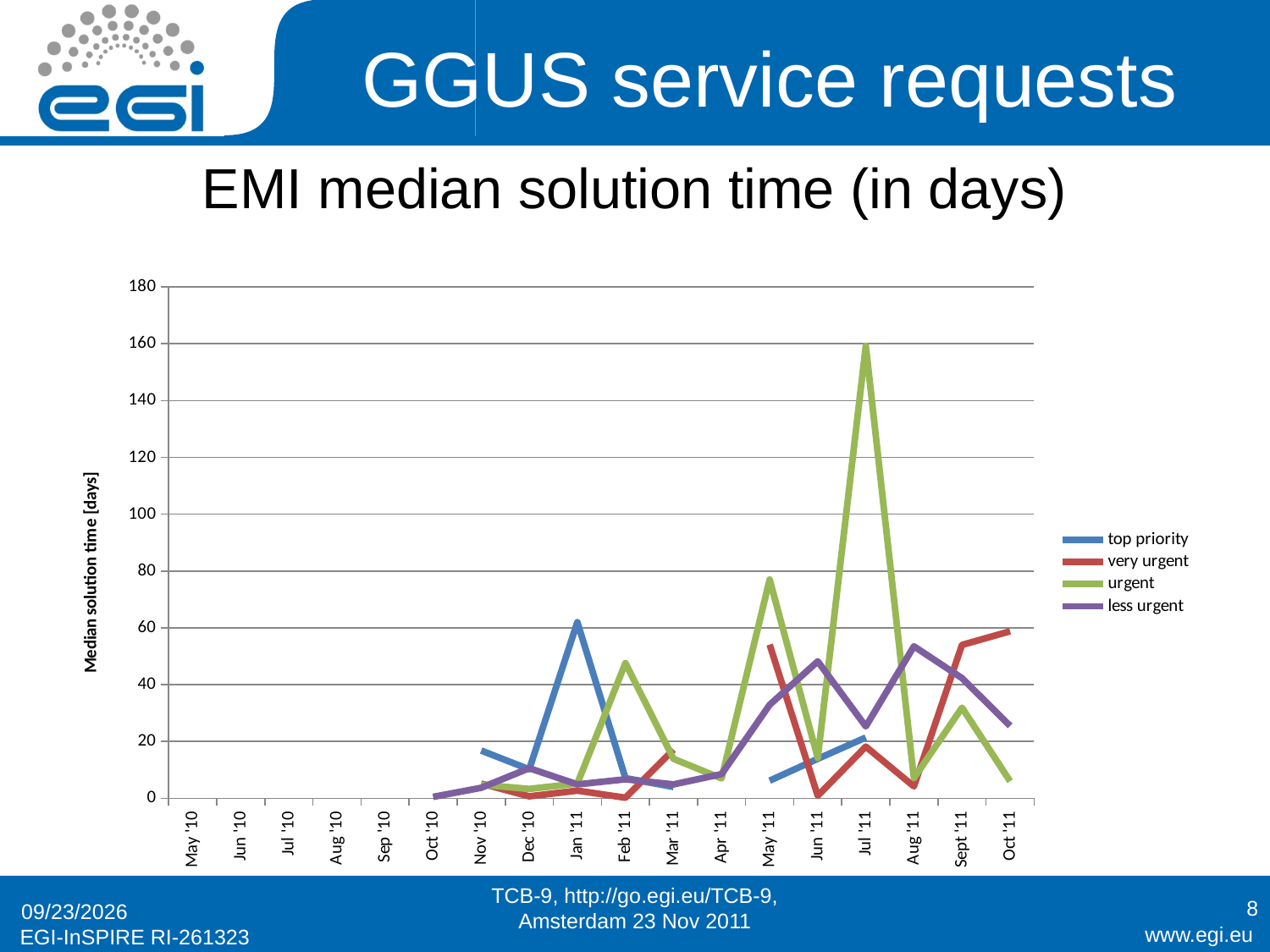
What kind of chart is shown on the slide? line chart Is the value for top priority in Jan '11 greater or less than 40? greater Is the value for urgent in May '11 greater or less than 60? greater How many series does the legend list? 4 In which month does the urgent series reach its peak? Jul '11 In Jul '11, which is larger: urgent or less urgent? urgent In Oct '11, which is larger: very urgent or urgent? very urgent How many months are shown along the x axis? 18 What is the label on the y axis? Median solution time [days] Is the value for urgent in Jul '11 greater or less than 140? greater Which series reaches the highest value on the chart? urgent Does the very urgent series rise or fall from Aug '11 to Oct '11? rise